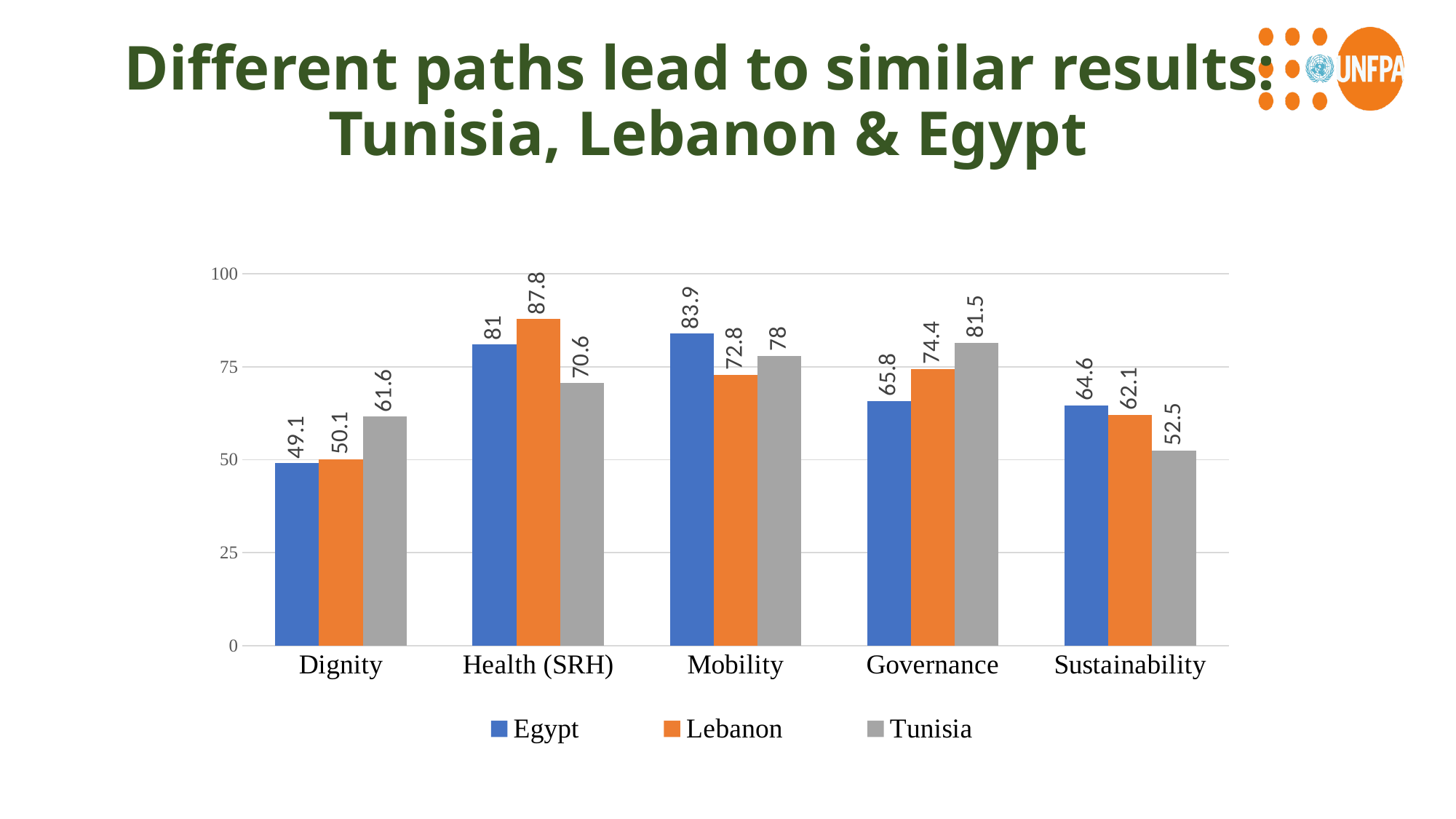
What is the value for Egypt in the Mobility category? 83.9 Which category has the highest value for Egypt? Mobility How many categories are shown on the x axis? 5 Which is larger in the Governance category: Egypt or Lebanon? Lebanon Is the value for Tunisia in the Health (SRH) category greater or less than 75? less What kind of chart is shown on the slide? bar chart What is the value for Tunisia in the Governance category? 81.5 Which category has the lowest value for Tunisia? Sustainability How many series does the legend list? 3 Which colour represents Lebanon in the chart? orange What is the difference between Tunisia's and Egypt's values in the Dignity category? 12.5 What is the value for Lebanon in the Health (SRH) category? 87.8